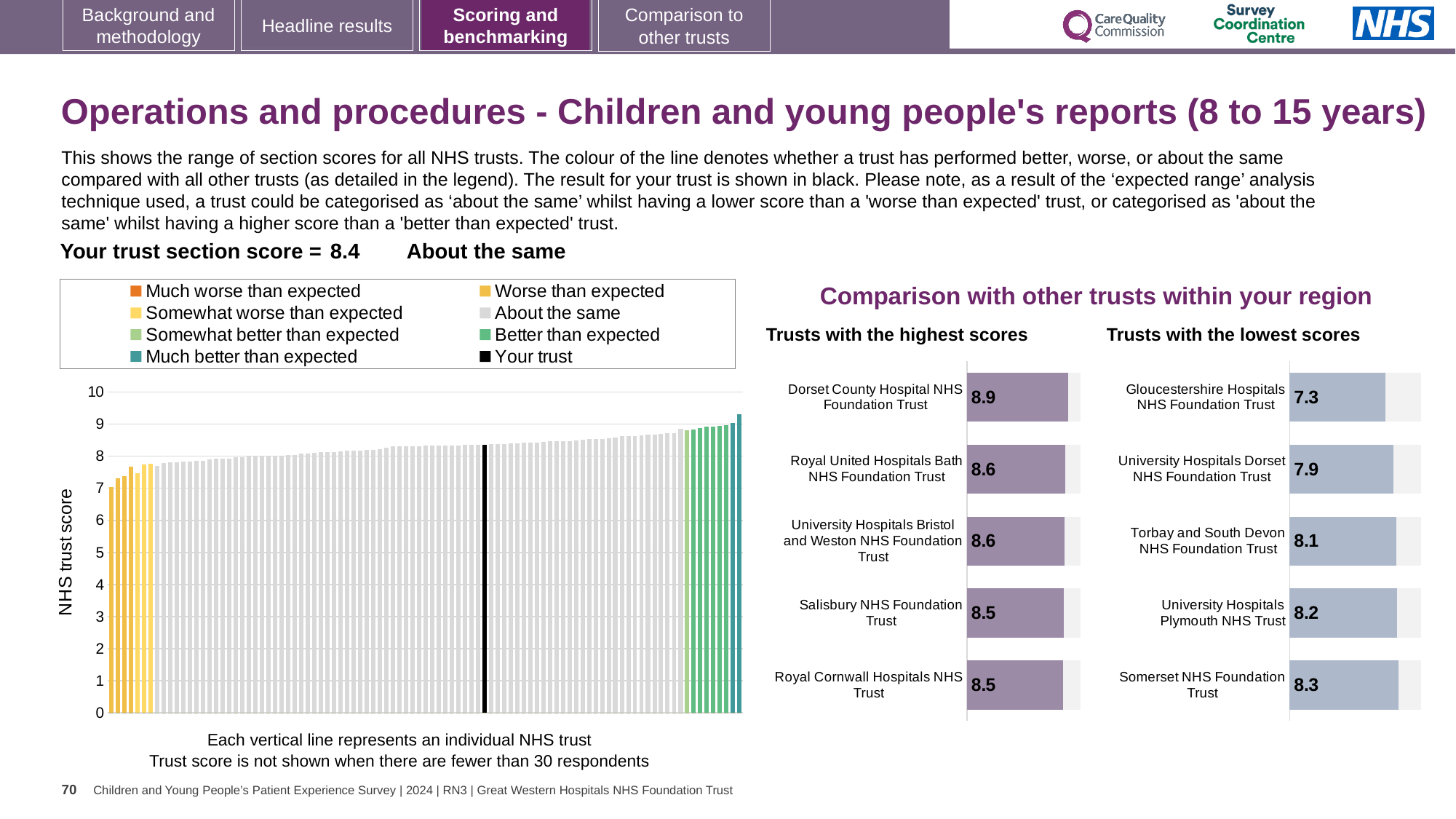
How many trusts are shown in the 'Trusts with the highest scores' chart? 5 In the 'Trusts with the highest scores' chart, what is the score for Dorset County Hospital NHS Foundation Trust? 8.9 What kind of chart is the large chart on the left showing NHS trust scores? Bar chart In the 'Trusts with the lowest scores' chart, what is the score for Gloucestershire Hospitals NHS Foundation Trust? 7.3 In the 'Trusts with the lowest scores' chart, which has the higher score: Torbay and South Devon NHS Foundation Trust or University Hospitals Plymouth NHS Trust? University Hospitals Plymouth NHS Trust In the 'Trusts with the lowest scores' chart, how much higher is Somerset NHS Foundation Trust's score than Gloucestershire Hospitals NHS Foundation Trust's score? 1.0 What is the label on the vertical axis of the large chart on the left? NHS trust score In the large chart on the left, do the trust scores rise or fall from left to right? Rise In the 'Trusts with the highest scores' chart, what is the difference between the scores of Dorset County Hospital NHS Foundation Trust and Salisbury NHS Foundation Trust? 0.4 In the 'Trusts with the highest scores' chart, which trust has the highest score? Dorset County Hospital NHS Foundation Trust In the 'Trusts with the lowest scores' chart, which trust has the lowest score? Gloucestershire Hospitals NHS Foundation Trust How many entries does the legend above the large chart on the left list? 8